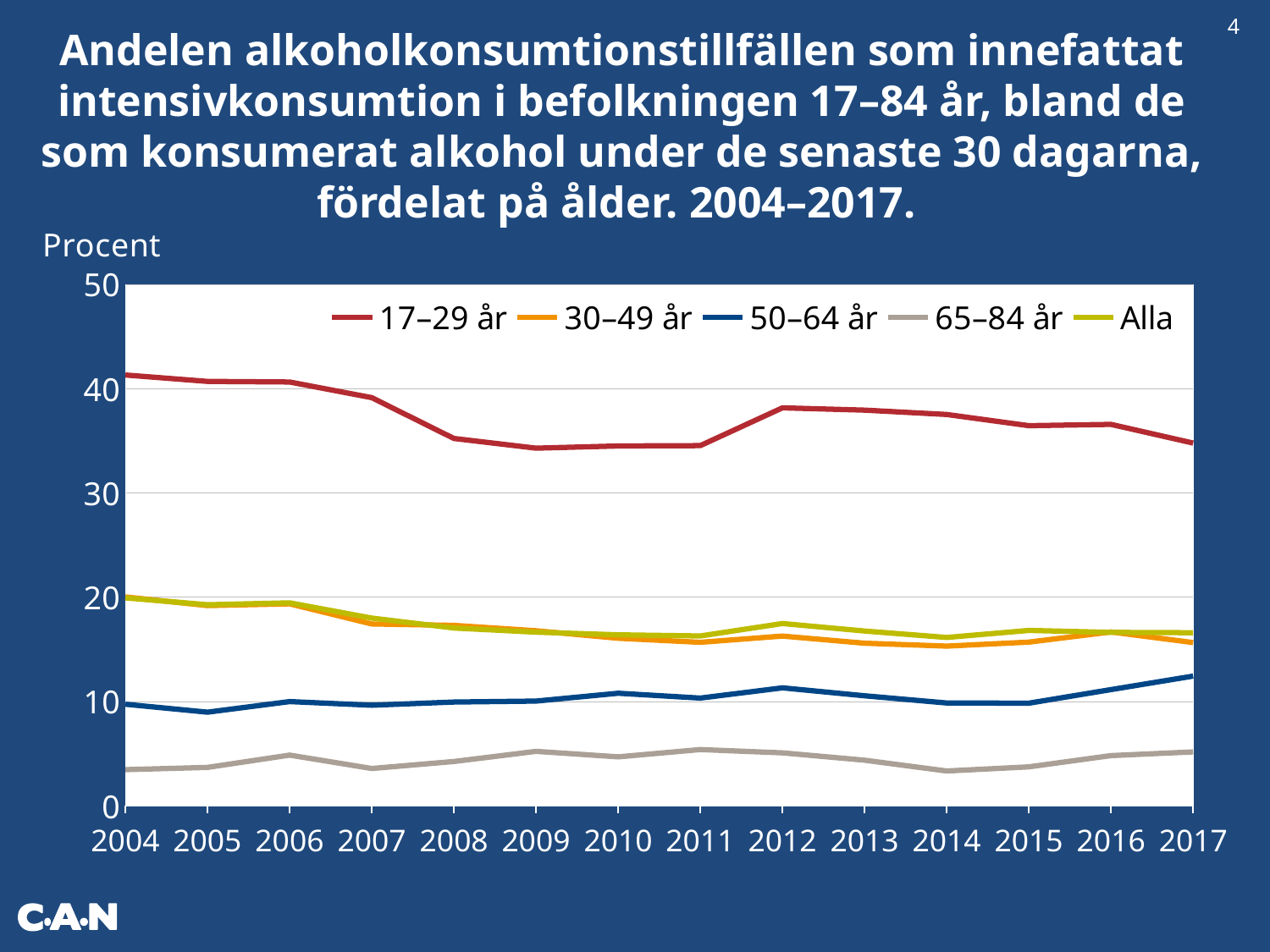
Which age group has the highest values throughout the period 2004–2017? 17–29 år Is the value for 17–29 år in 2009 greater or less than 40? less Is the value for 65–84 år in 2014 greater or less than 10? less What kind of chart is shown on the slide? line chart Which age group has the lowest values throughout the period 2004–2017? 65–84 år Does the value for 17–29 år rise or fall from 2004 to 2009? fall Is the value for 50–64 år in 2017 greater or less than 10? greater How many series does the legend list? 5 How many years are plotted along the x axis? 14 Which is larger in 2017, the value for 50–64 år or the value for 65–84 år? 50–64 år What is the label of the y axis? Procent